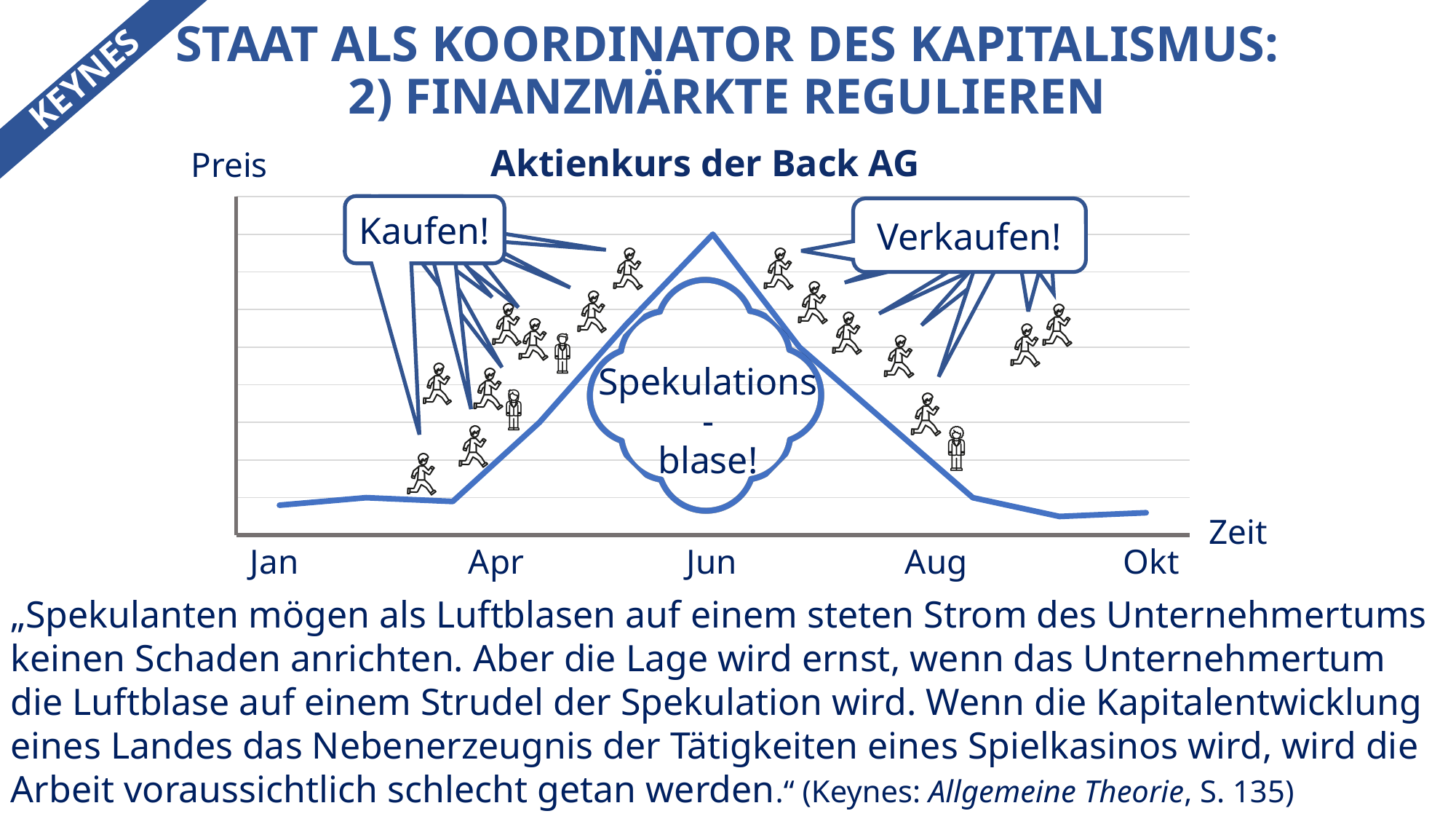
How many labels are shown on the x axis of the chart? 5 What kind of chart is shown on the slide? line chart Is the share price higher at Jun or at Apr? Jun Does the share price rise or fall between Jun and Aug? fall Does the share price rise or fall between Aug and Okt? fall Is the share price higher at Jun or at Okt? Jun How many data series are plotted in the chart? 1 At which x-axis label does the share price reach its highest point? Jun What label is written on the y axis of the chart? Preis What is the title of the chart? Aktienkurs der Back AG Does the share price rise or fall between Apr and Jun? rise